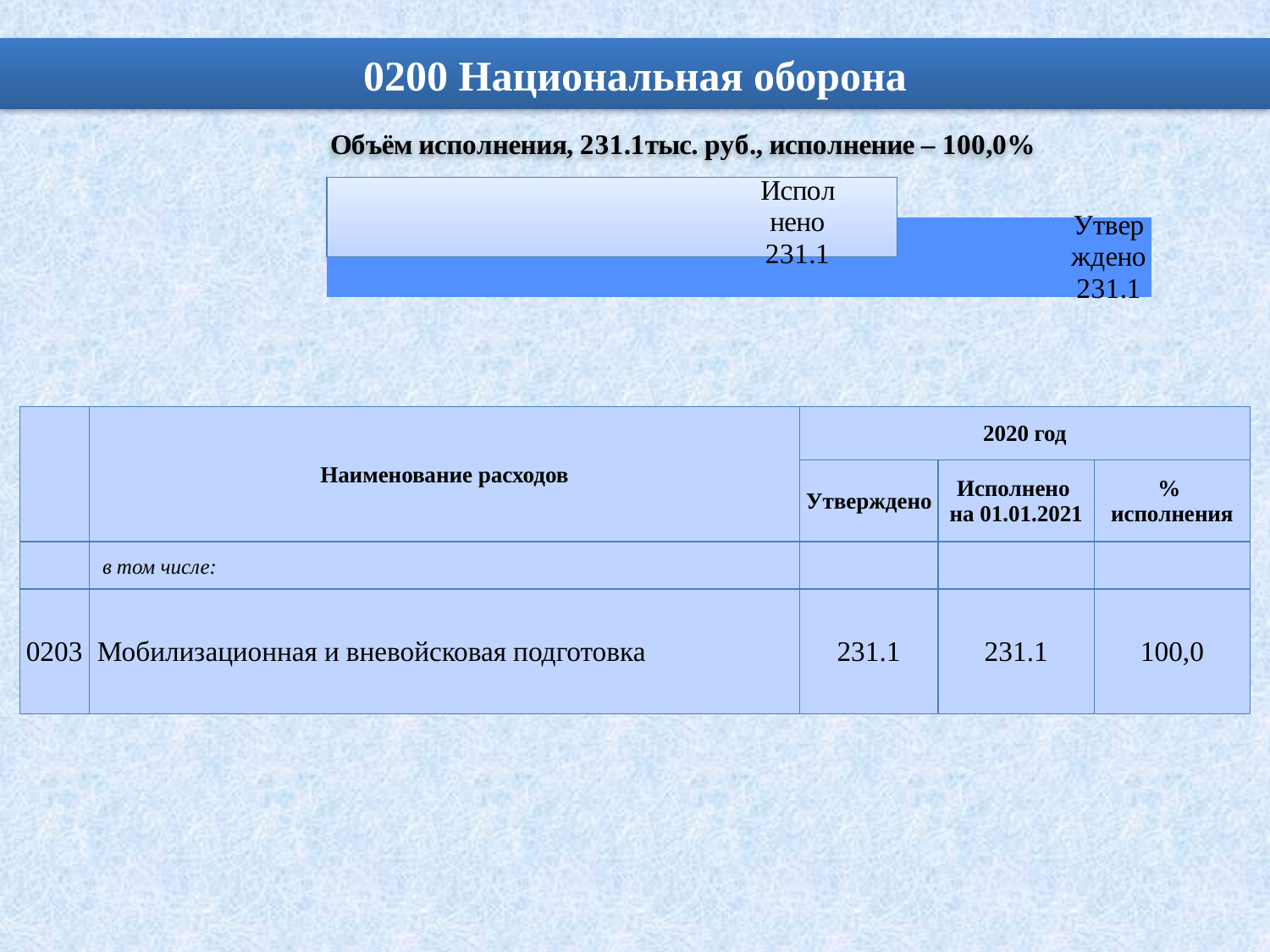
What value is shown for the Утверждено bar in the chart? 231.1 What kind of chart is shown on the slide? bar chart What is the heading printed directly above the chart? Объём исполнения, 231.1тыс. руб., исполнение – 100,0% What is the difference between the Утверждено value and the Исполнено value in the chart? 0 How many bars are plotted in the chart? 2 What value is shown for the Исполнено bar in the chart? 231.1 Are the bars in the chart horizontal or vertical? horizontal